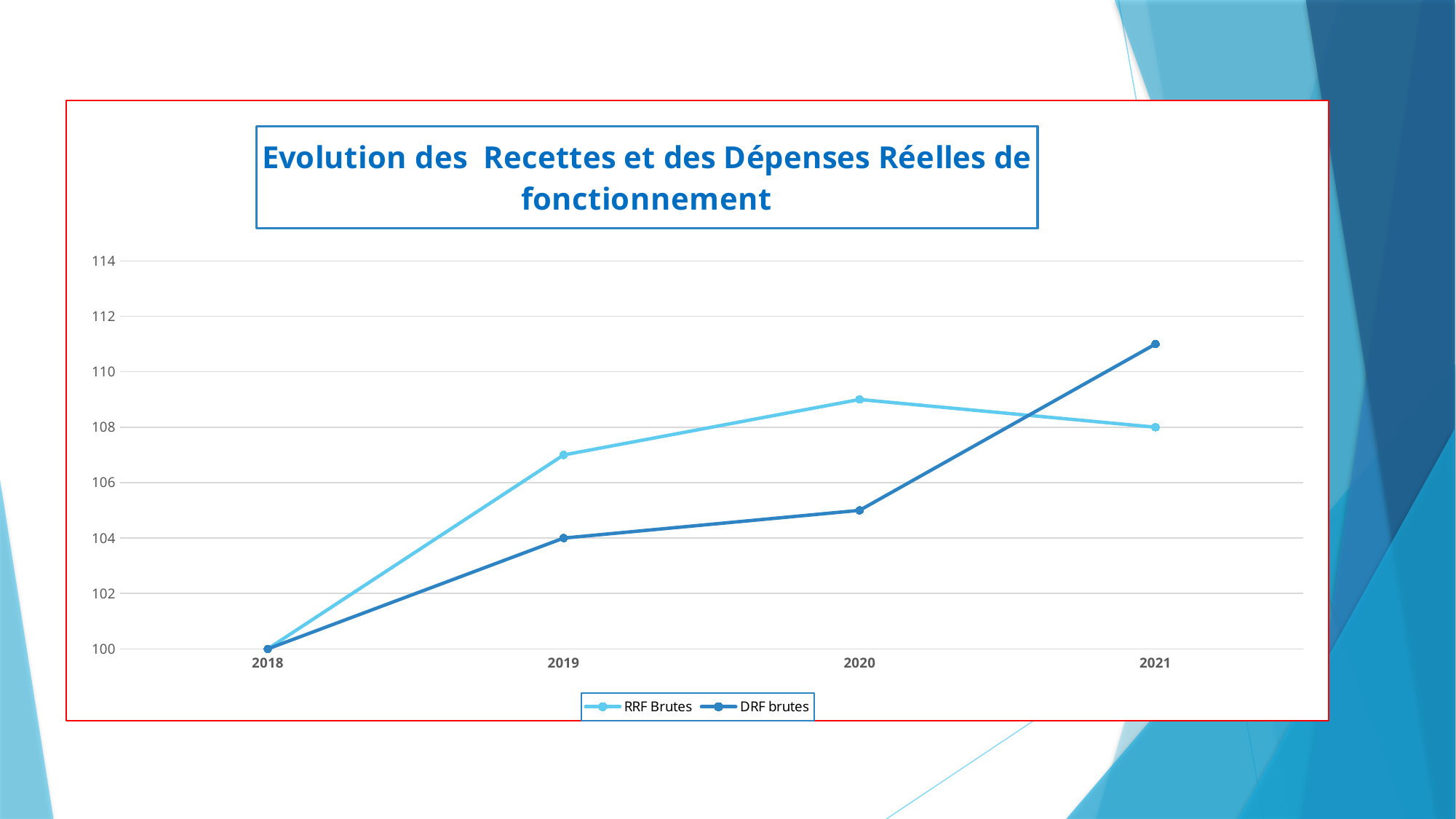
What is the value of RRF Brutes in 2018? 100 Is the value for DRF brutes in 2020 greater or less than 106? less What is the value of RRF Brutes in 2021? 108 Is the value for RRF Brutes in 2019 greater or less than 106? greater Does the DRF brutes line rise or fall from 2018 to 2021? rise In which year does DRF brutes reach its highest value? 2021 How many years are plotted along the x axis? 4 In 2020, which series has the higher value, RRF Brutes or DRF brutes? RRF Brutes What kind of chart is shown on the slide? line chart How many series does the legend list? 2 What is the value of DRF brutes in 2019? 104 Is the value for DRF brutes in 2021 greater or less than 110? greater